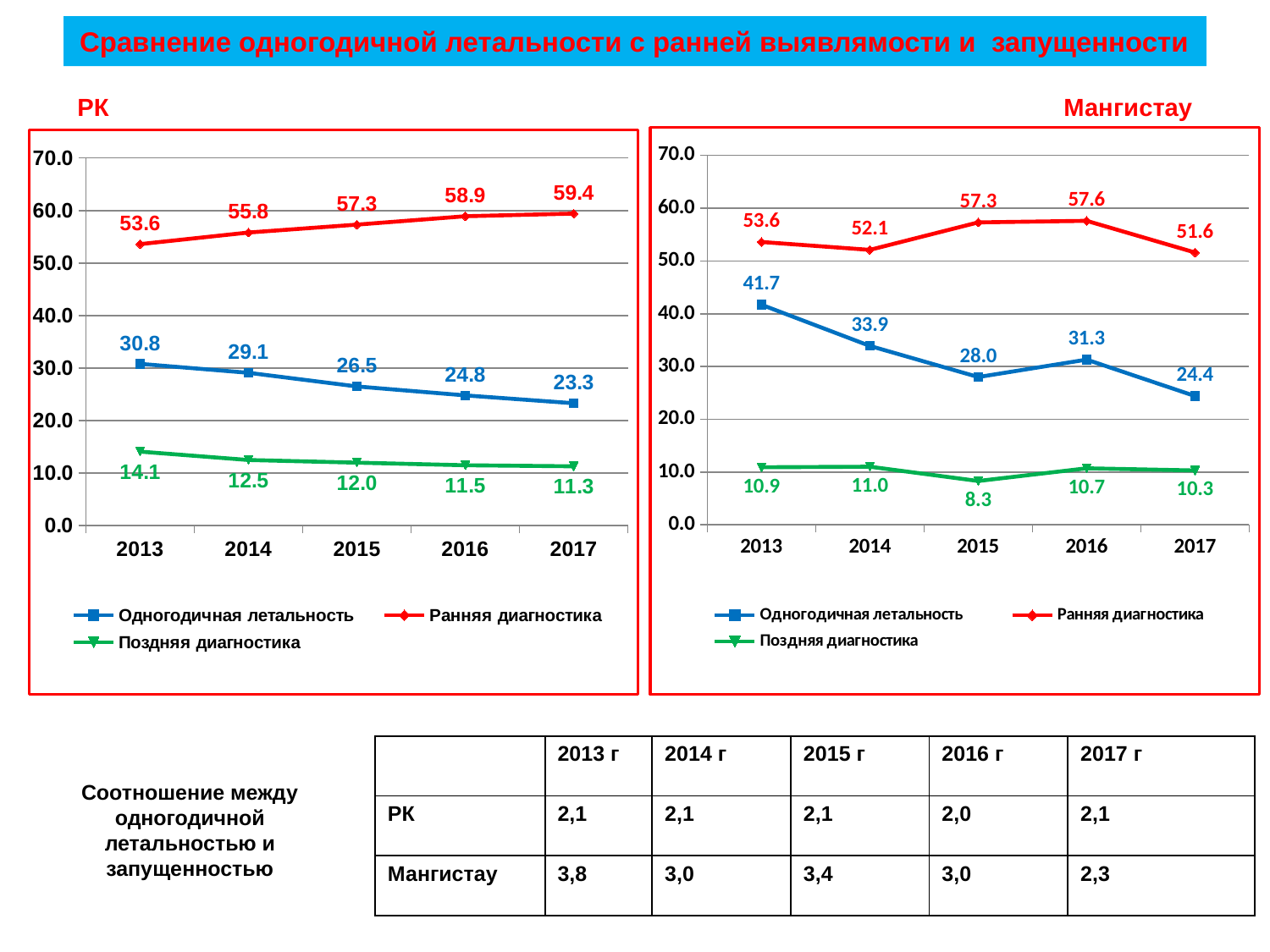
In the Мангистау chart, in which year is Ранняя диагностика lowest? 2017 What type of chart is the Мангистау chart? line chart In the Мангистау chart, what is the value of Одногодичная летальность in 2013? 41.7 In the Мангистау chart, which is larger in 2016: Одногодичная летальность or Поздняя диагностика? Одногодичная летальность In the Мангистау chart, what is the value of Поздняя диагностика in 2015? 8.3 How many years are shown on the x axis of the Мангистау chart? 5 How many series does the legend of the РК chart list? 3 In the РК chart, in which year is Одногодичная летальность highest? 2013 In the РК chart, what is the difference between Ранняя диагностика and Одногодичная летальность in 2013? 22.8 In the РК chart, does Одногодичная летальность rise or fall from 2013 to 2017? fall In the РК chart, does Ранняя диагностика rise or fall from 2013 to 2017? rise In the РК chart, what is the value of Ранняя диагностика in 2017? 59.4